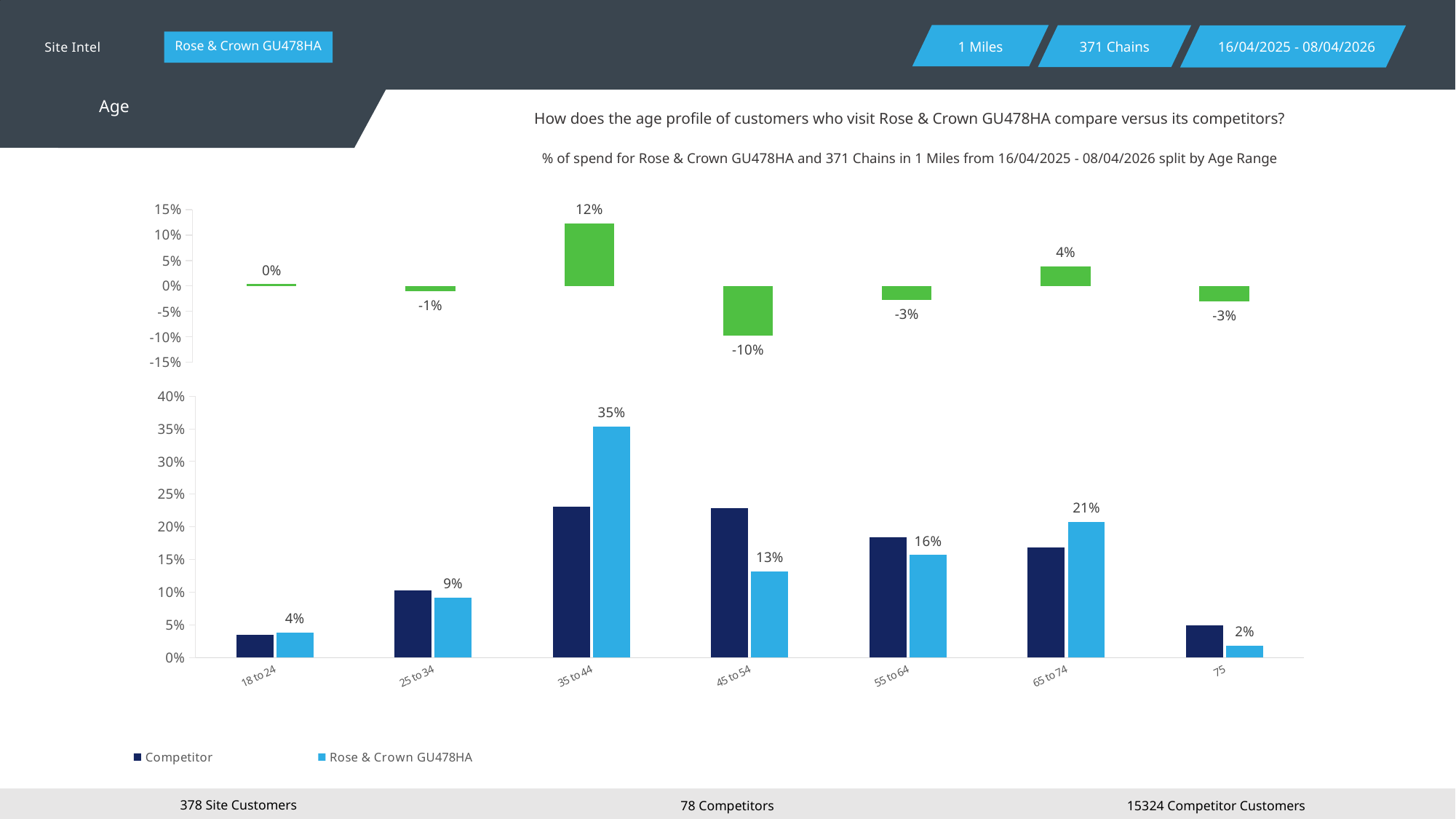
On the bottom chart, what is the value for Rose & Crown GU478HA in the 35 to 44 age range? 35% On the bottom chart, what is the value for Rose & Crown GU478HA in the 65 to 74 age range? 21% On the bottom chart, which age range has the lowest value for Rose & Crown GU478HA? 75 How many series does the legend of the bottom chart list? 2 On the bottom chart, which age range has the highest value for Rose & Crown GU478HA? 35 to 44 On the bottom chart, is the Competitor value for 75 greater or less than 10%? less On the bottom chart, what is the difference between the Rose & Crown GU478HA values for 35 to 44 and 45 to 54? 22% How many age range categories are shown on the bottom chart? 7 What kind of chart is the bottom chart? bar chart On the top chart, what is the highest value shown? 12% On the bottom chart, which is larger for the 45 to 54 age range: Competitor or Rose & Crown GU478HA? Competitor On the bottom chart, is the Competitor value for 35 to 44 greater or less than 20%? greater